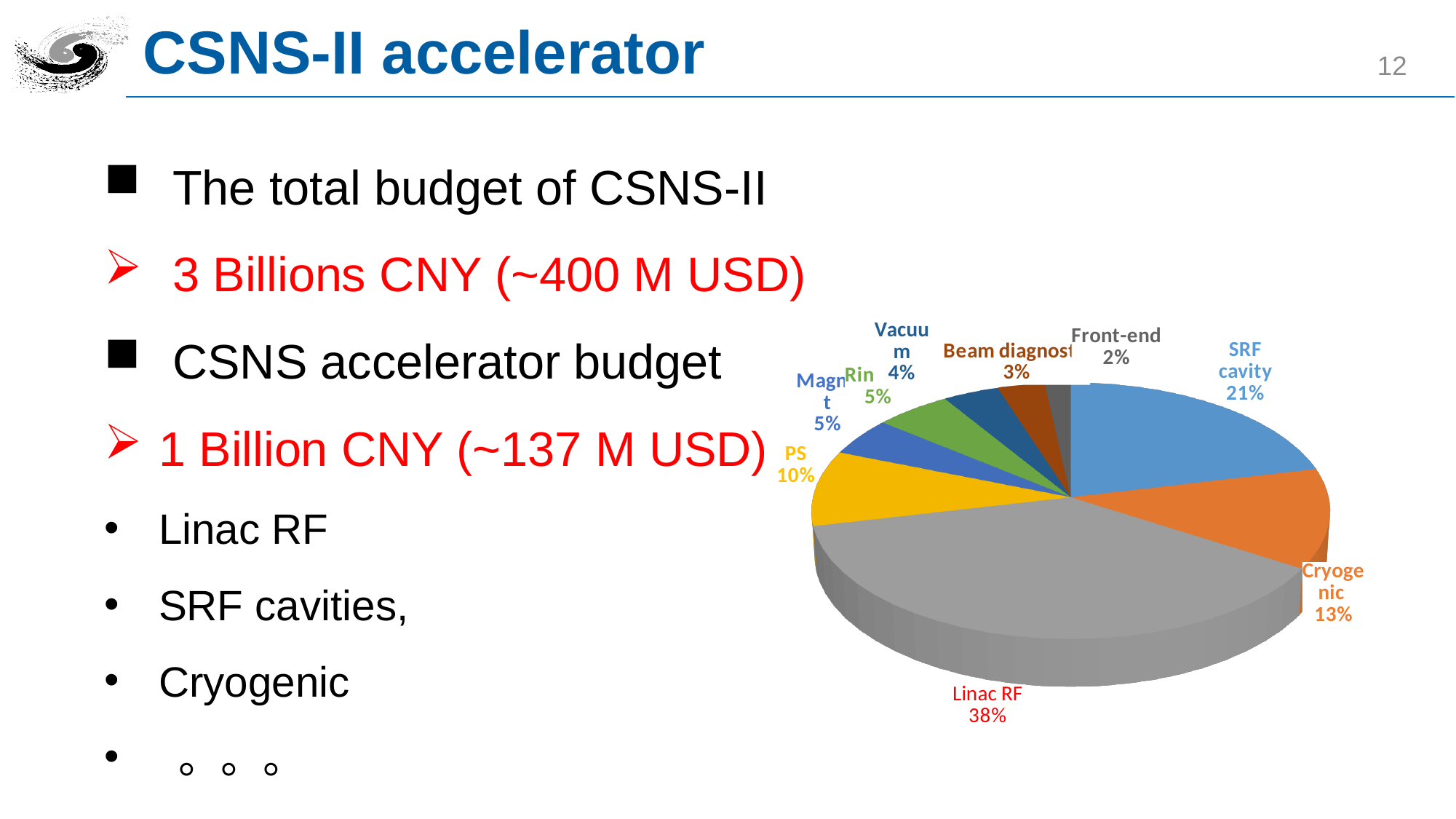
What share of the accelerator budget goes to Linac RF? 38% What percentage is shown for Vacuum? 4% What percentage is shown for Front-end? 2% Which category has the smallest share of the pie? Front-end How many slices does the pie chart have? 9 What kind of chart is shown on the slide? pie chart Which category has the largest share of the pie? Linac RF Which has a larger share, Cryogenic or PS? Cryogenic What share of the budget is for SRF cavity? 21% How many percentage points larger is the Linac RF share than the SRF cavity share? 17 What percentage is shown for Cryogenic? 13% What percentage is shown for PS? 10%